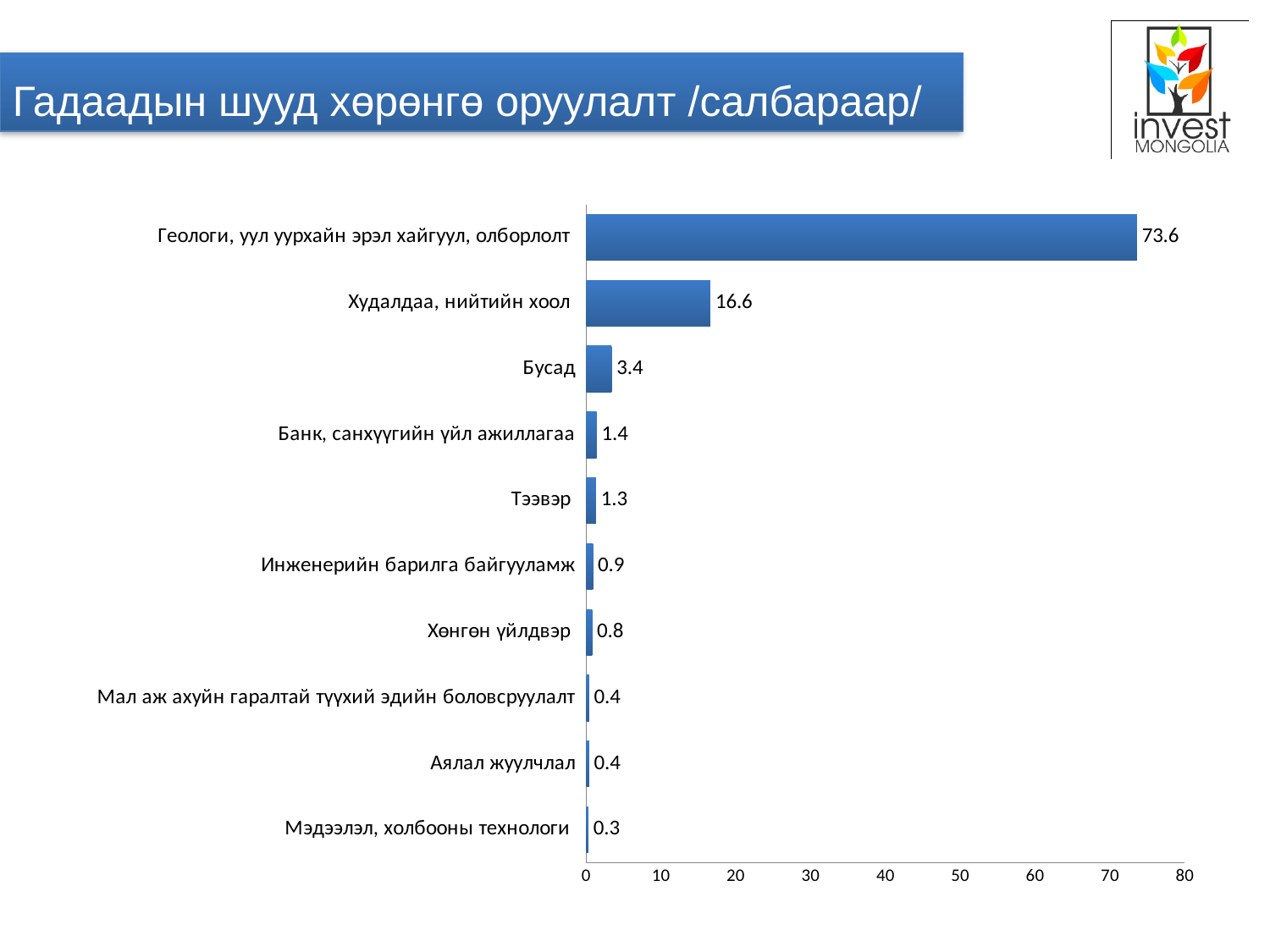
Is the value for Худалдаа, нийтийн хоол greater or less than 20? less What is the value for Геологи, уул уурхайн эрэл хайгуул, олборлолт? 73.6 What kind of chart is shown on the slide? bar chart What is the value for Тээвэр? 1.3 Which category has the lowest value? Мэдээлэл, холбооны технологи What is the difference between the values for Геологи, уул уурхайн эрэл хайгуул, олборлолт and Худалдаа, нийтийн хоол? 57.0 Which category has the highest value? Геологи, уул уурхайн эрэл хайгуул, олборлолт Which is larger, the value for Банк, санхүүгийн үйл ажиллагаа or the value for Хөнгөн үйлдвэр? Банк, санхүүгийн үйл ажиллагаа What is the value for Бусад? 3.4 How many categories are shown in the chart? 10 What is the title of the slide? Гадаадын шууд хөрөнгө оруулалт /салбараар/ What is the value for Худалдаа, нийтийн хоол? 16.6